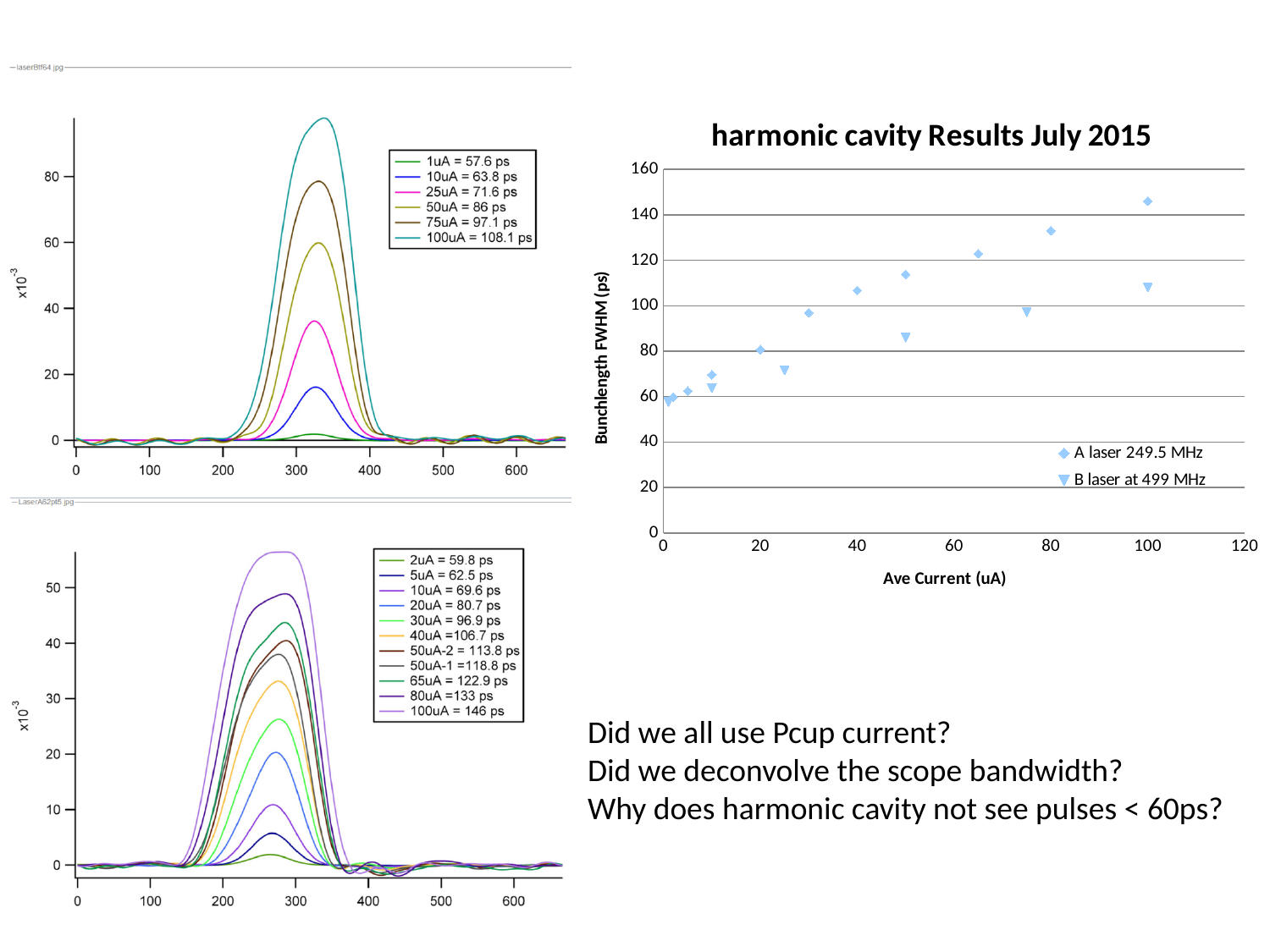
In the bottom-left chart, what value does the legend give for 65uA? 122.9 ps In the 'harmonic cavity Results July 2015' chart, which series has the larger value at 100 uA, A laser 249.5 MHz or B laser at 499 MHz? A laser 249.5 MHz What is the title of the chart on the right side of the slide? harmonic cavity Results July 2015 In the 'harmonic cavity Results July 2015' chart, is the B laser at 499 MHz value at 75 uA greater or less than 100? less What is the label of the x axis of the 'harmonic cavity Results July 2015' chart? Ave Current (uA) How many entries does the legend of the bottom-left chart list? 11 In the top-left chart, what value does the legend give for 100uA? 108.1 ps In the 'harmonic cavity Results July 2015' chart, does the bunchlength for A laser 249.5 MHz rise or fall as average current increases? rise In the 'harmonic cavity Results July 2015' chart, is the B laser at 499 MHz value at 100 uA greater or less than 120? less In the 'harmonic cavity Results July 2015' chart, is the A laser 249.5 MHz value at 100 uA greater or less than 140? greater How many series does the legend of the 'harmonic cavity Results July 2015' chart list? 2 What kind of chart is the 'harmonic cavity Results July 2015' chart? scatter chart